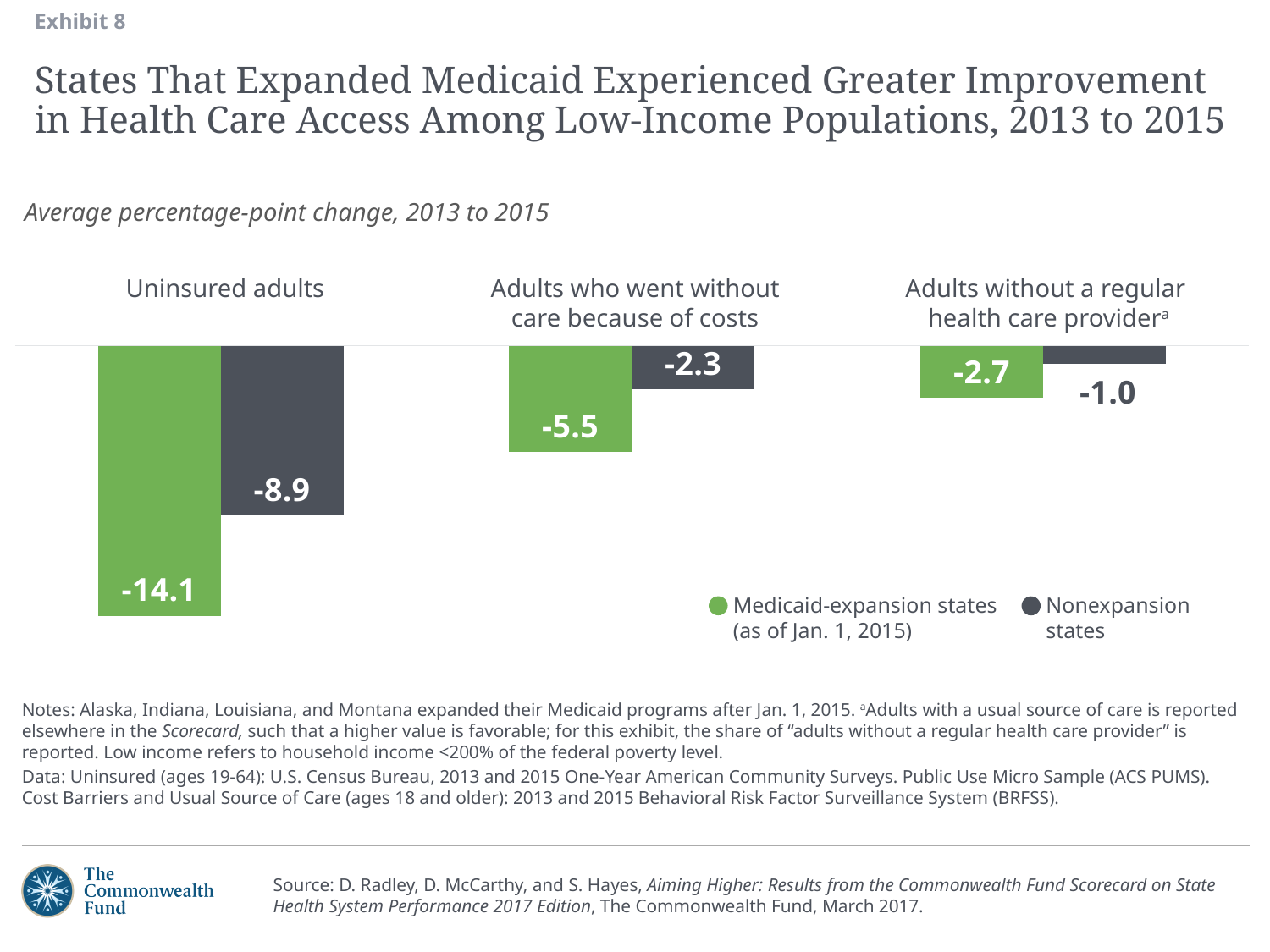
Which category shows the smallest decline for Nonexpansion states? Adults without a regular health care provider Which category shows the largest decline for Medicaid-expansion states? Uninsured adults What is the value for Medicaid-expansion states for Uninsured adults? -14.1 What is the value for Nonexpansion states for Uninsured adults? -8.9 How many series does the legend list? 2 What is the difference between the Medicaid-expansion and Nonexpansion values for Adults who went without care because of costs? 3.2 What is the value for Medicaid-expansion states for Adults who went without care because of costs? -5.5 Which group had the larger decline in Adults without a regular health care provider, Medicaid-expansion states or Nonexpansion states? Medicaid-expansion states What is the value for Nonexpansion states for Adults without a regular health care provider? -1.0 How many categories are shown on the chart? 3 What is the difference between the Medicaid-expansion and Nonexpansion values for Uninsured adults? 5.2 What kind of chart is shown on the slide? Bar chart